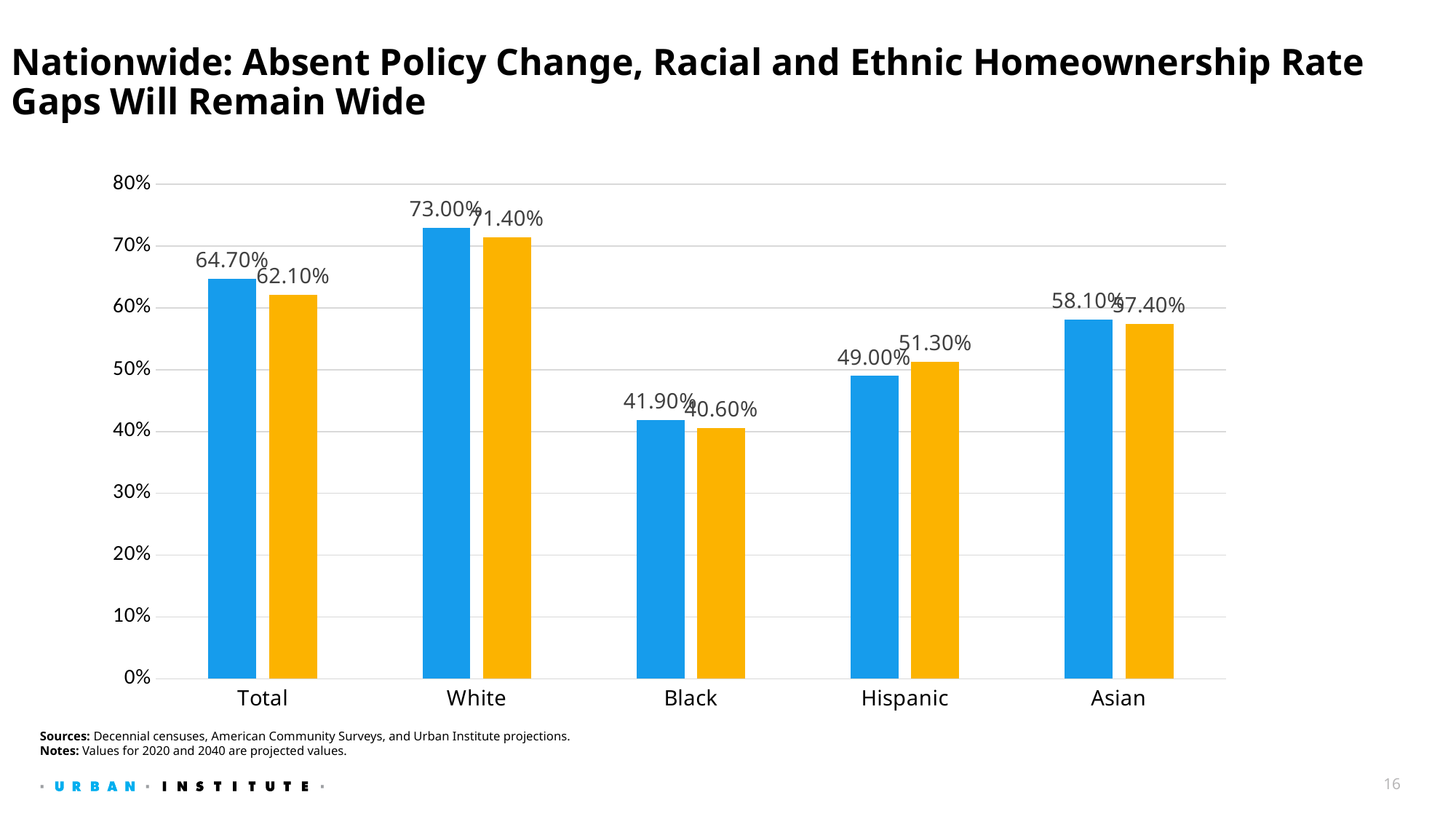
What is the title of the slide? Nationwide: Absent Policy Change, Racial and Ethnic Homeownership Rate Gaps Will Remain Wide What is the value of the orange bar for Hispanic? 51.30% Which category has the lowest orange bar? Black What kind of chart is shown on the slide? bar chart What is the difference between the blue and orange bars for Total? 2.60% For Hispanic, which bar is larger, the blue or the orange? orange What is the difference between the blue bars for White and Black? 31.10% Which category has the highest blue bar? White What is the value of the blue bar for Black? 41.90% What is the value of the orange bar for Total? 62.10% How many categories are shown on the x axis? 5 What is the value of the blue bar for White? 73.00%